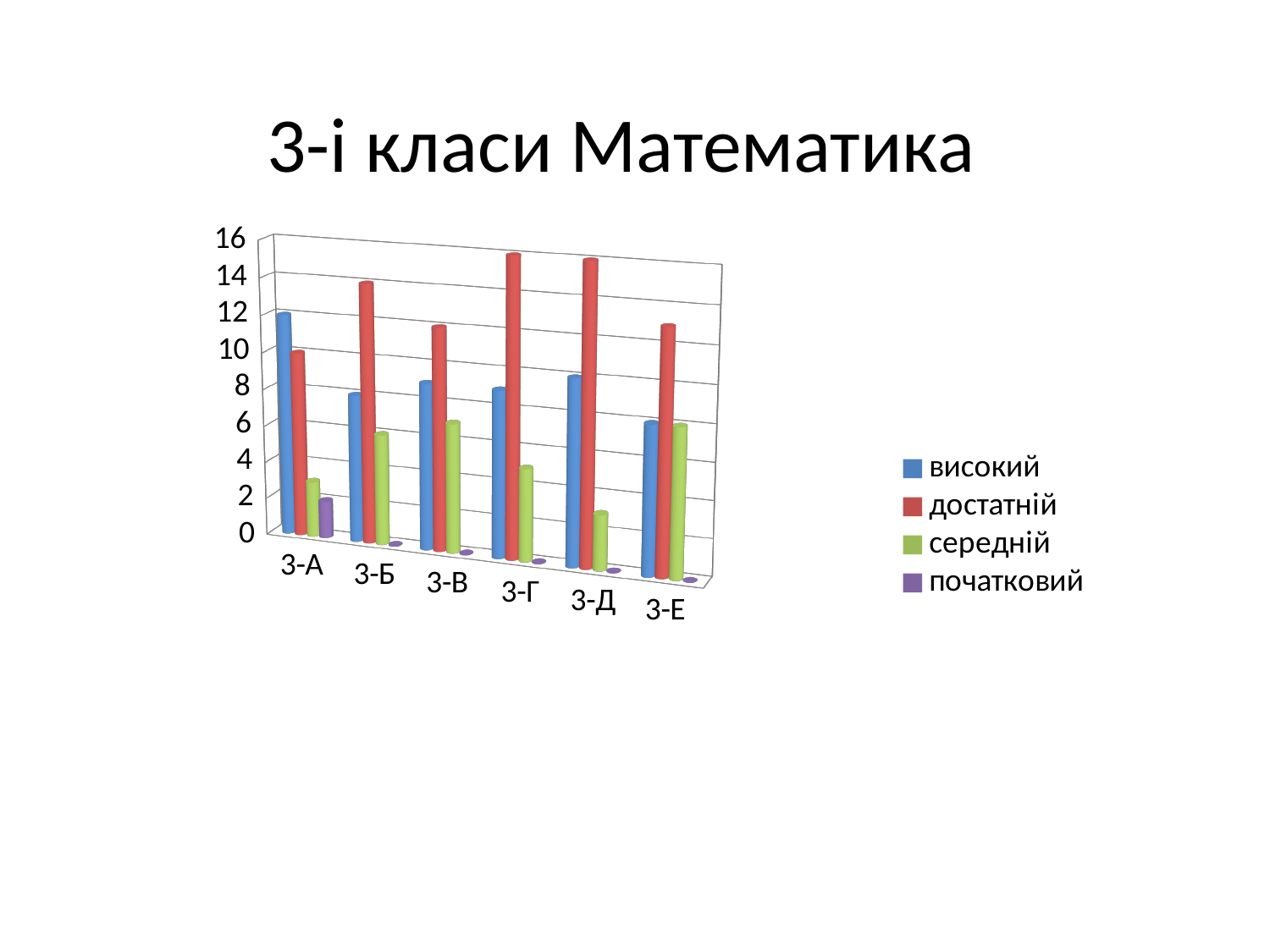
Which colour represents the series 'достатній' in the legend? red In class 3-А, which is larger: 'високий' or 'достатній'? високий How many classes (categories) are shown on the x axis? 6 What kind of chart is shown on the slide? bar chart Is the value for 'початковий' in class 3-А greater or less than 4? less Is the value for 'достатній' in class 3-Г greater or less than 12? greater What is the title of the slide? 3-і класи Математика Which class has the highest value for 'високий'? 3-А In class 3-Б, which is larger: 'високий' or 'достатній'? достатній How many series does the legend list? 4 Is the value for 'високий' in class 3-А greater or less than 10? greater